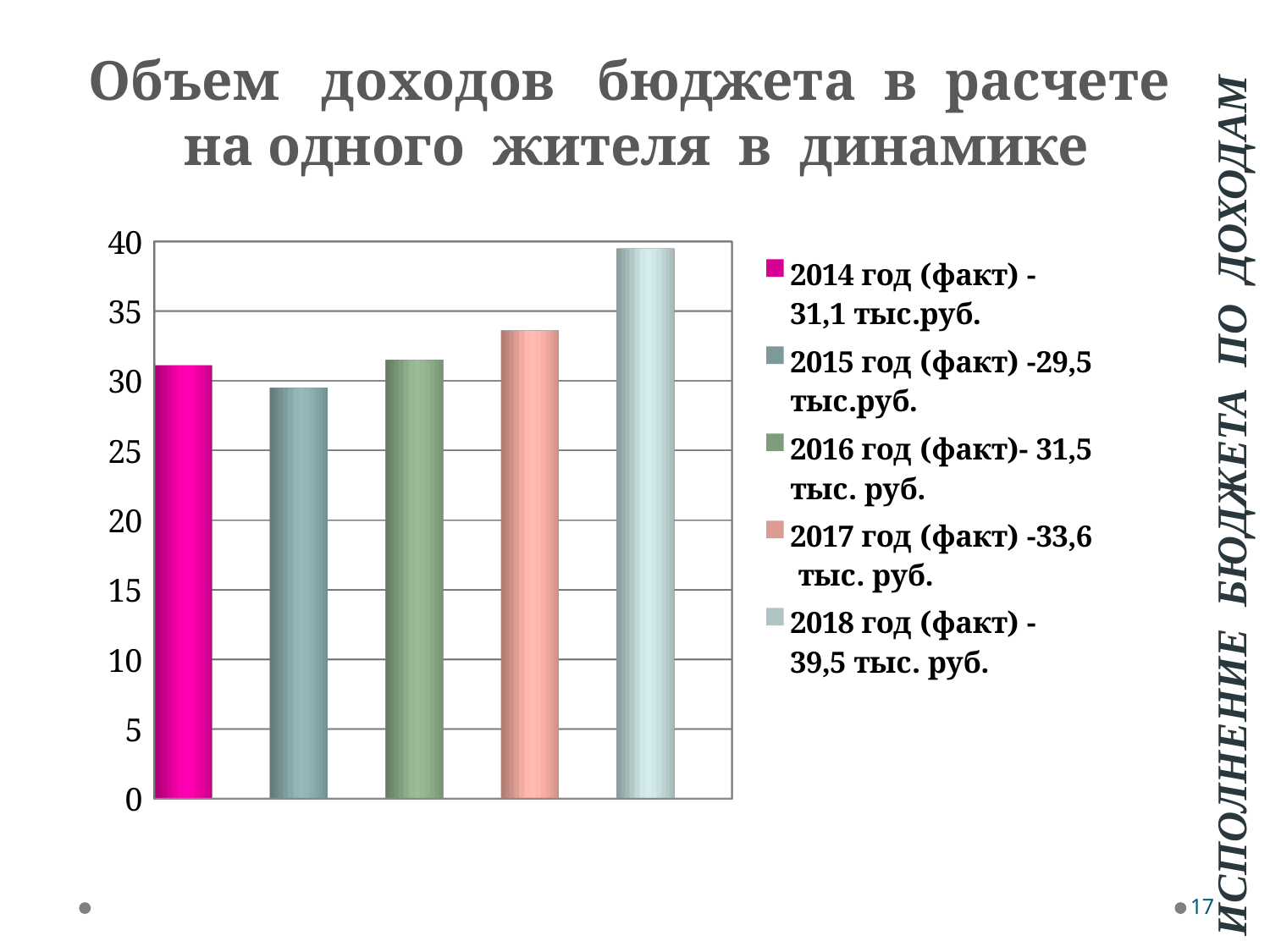
Which year has the highest value in the chart? 2018 год (факт) Which is larger, the value for 2016 год (факт) or the value for 2015 год (факт)? 2016 год (факт) Is the value for 2017 год (факт) greater or less than 30? greater Which year has the lowest value in the chart? 2015 год (факт) How many bars are plotted in the chart? 5 What is the value for 2014 год (факт) in the chart? 31,1 тыс.руб. What is the value for 2018 год (факт) in the chart? 39,5 тыс. руб. What is the value for 2017 год (факт) in the chart? 33,6 тыс. руб. How many entries does the legend list? 5 What is the title of the chart on the slide? Объем доходов бюджета в расчете на одного жителя в динамике What is the difference between the values for 2018 год (факт) and 2014 год (факт)? 8,4 тыс. руб. What kind of chart is shown on the slide? bar chart